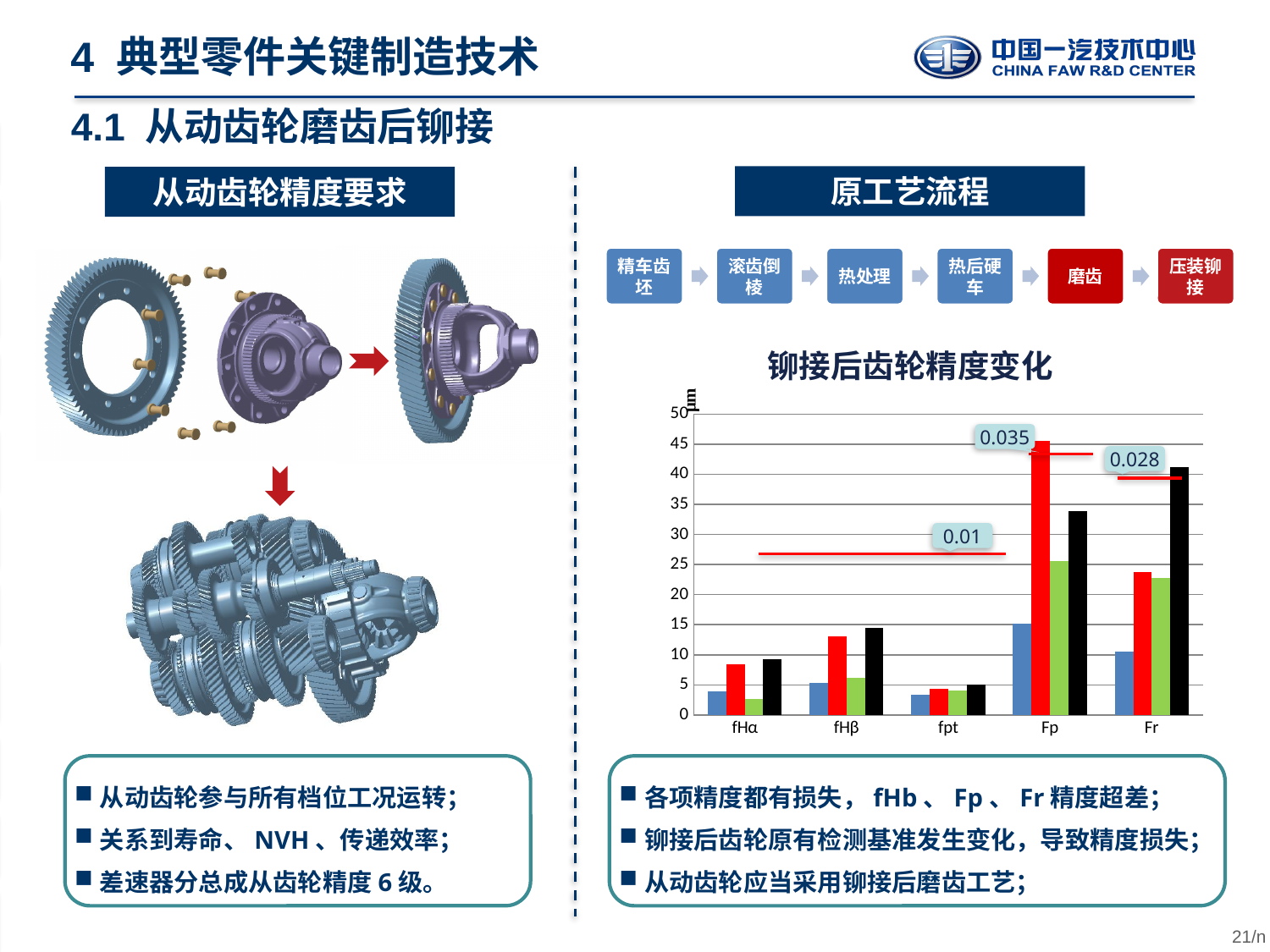
How many categories are shown on the x axis of the 铆接后齿轮精度变化 chart? 5 Which category has the lowest bars overall in the 铆接后齿轮精度变化 chart? fpt Is the blue bar for Fp greater or less than 20 in the 铆接后齿轮精度变化 chart? less What unit is shown on the y axis of the 铆接后齿轮精度变化 chart? μm How many bars are plotted for each category in the 铆接后齿轮精度变化 chart? 4 Which category has the tallest bar in the 铆接后齿轮精度变化 chart? Fp Is the red bar for Fp greater or less than 40 in the 铆接后齿轮精度变化 chart? greater What kind of chart is shown under the title 铆接后齿轮精度变化? bar chart Which is larger in the 铆接后齿轮精度变化 chart: the red bar for Fp or the red bar for Fr? Fp Is the blue bar for fHα greater or less than 5 in the 铆接后齿轮精度变化 chart? less What value is labelled on the annotation line above the Fp bars in the 铆接后齿轮精度变化 chart? 0.035